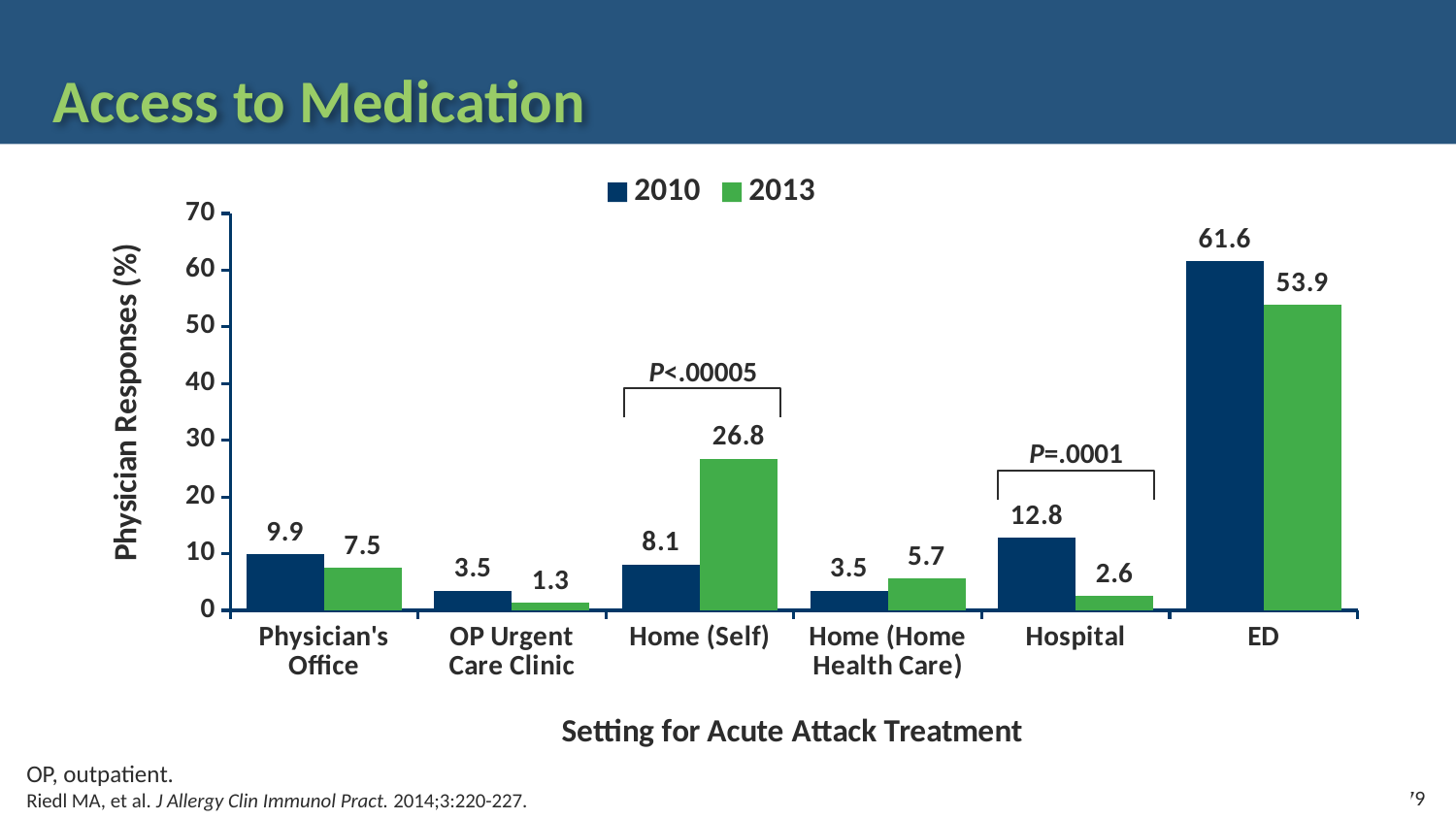
What is the 2013 value for Hospital? 2.6 Is the 2013 value for ED greater or less than 50? greater Which is larger for Hospital, the 2010 value or the 2013 value? 2010 Which setting has the highest 2013 value? ED How many settings are shown on the x axis? 6 What is the 2010 value for ED? 61.6 What kind of chart is shown on the slide? bar chart Which setting has the lowest 2013 value? OP Urgent Care Clinic How many series does the legend list? 2 What is the difference between the 2010 and 2013 values for ED? 7.7 What is the 2013 value for Home (Self)? 26.8 What is the difference between the 2013 and 2010 values for Home (Self)? 18.7